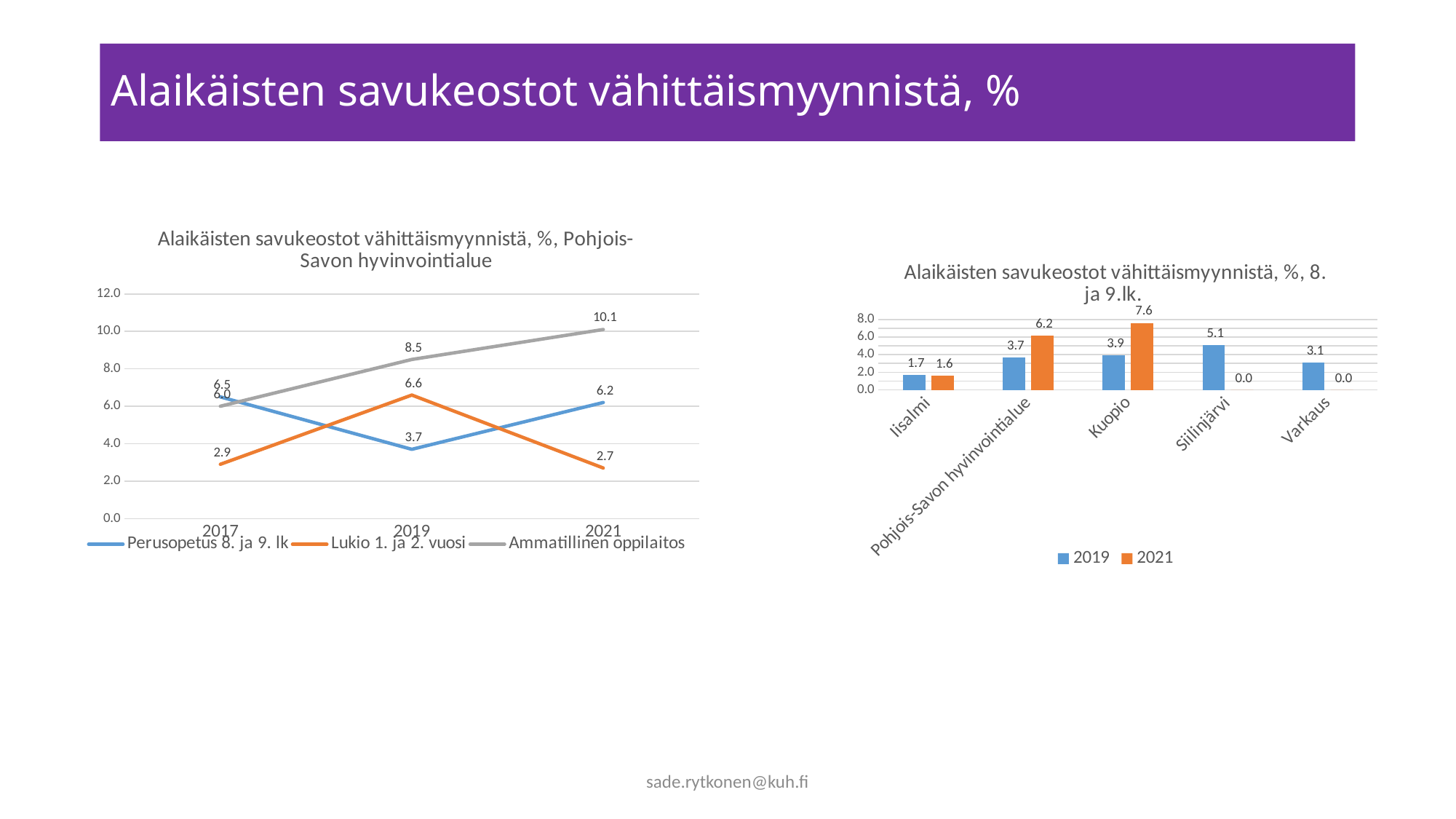
In the left chart (Pohjois-Savon hyvinvointialue), what is the difference between Ammatillinen oppilaitos and Lukio 1. ja 2. vuosi in 2021? 7.4 In the left chart (Pohjois-Savon hyvinvointialue), how many series does the legend list? 3 What kind of chart is the right chart (8. ja 9.lk)? bar chart In the right chart (8. ja 9.lk), which is larger for Pohjois-Savon hyvinvointialue, the 2019 value or the 2021 value? 2021 In the left chart (Pohjois-Savon hyvinvointialue), what is the value for Perusopetus 8. ja 9. lk in 2019? 3.7 In the right chart (8. ja 9.lk), what is the 2021 value for Kuopio? 7.6 In the left chart (Pohjois-Savon hyvinvointialue), does the Ammatillinen oppilaitos line rise or fall from 2017 to 2021? rise In the left chart (Pohjois-Savon hyvinvointialue), what is the value for Lukio 1. ja 2. vuosi in 2019? 6.6 What kind of chart is the left chart (Pohjois-Savon hyvinvointialue)? line chart In the right chart (8. ja 9.lk), how many categories are shown on the x axis? 5 In the left chart (Pohjois-Savon hyvinvointialue), what is the value for Ammatillinen oppilaitos in 2021? 10.1 In the right chart (8. ja 9.lk), which category has the highest 2019 value? Siilinjärvi